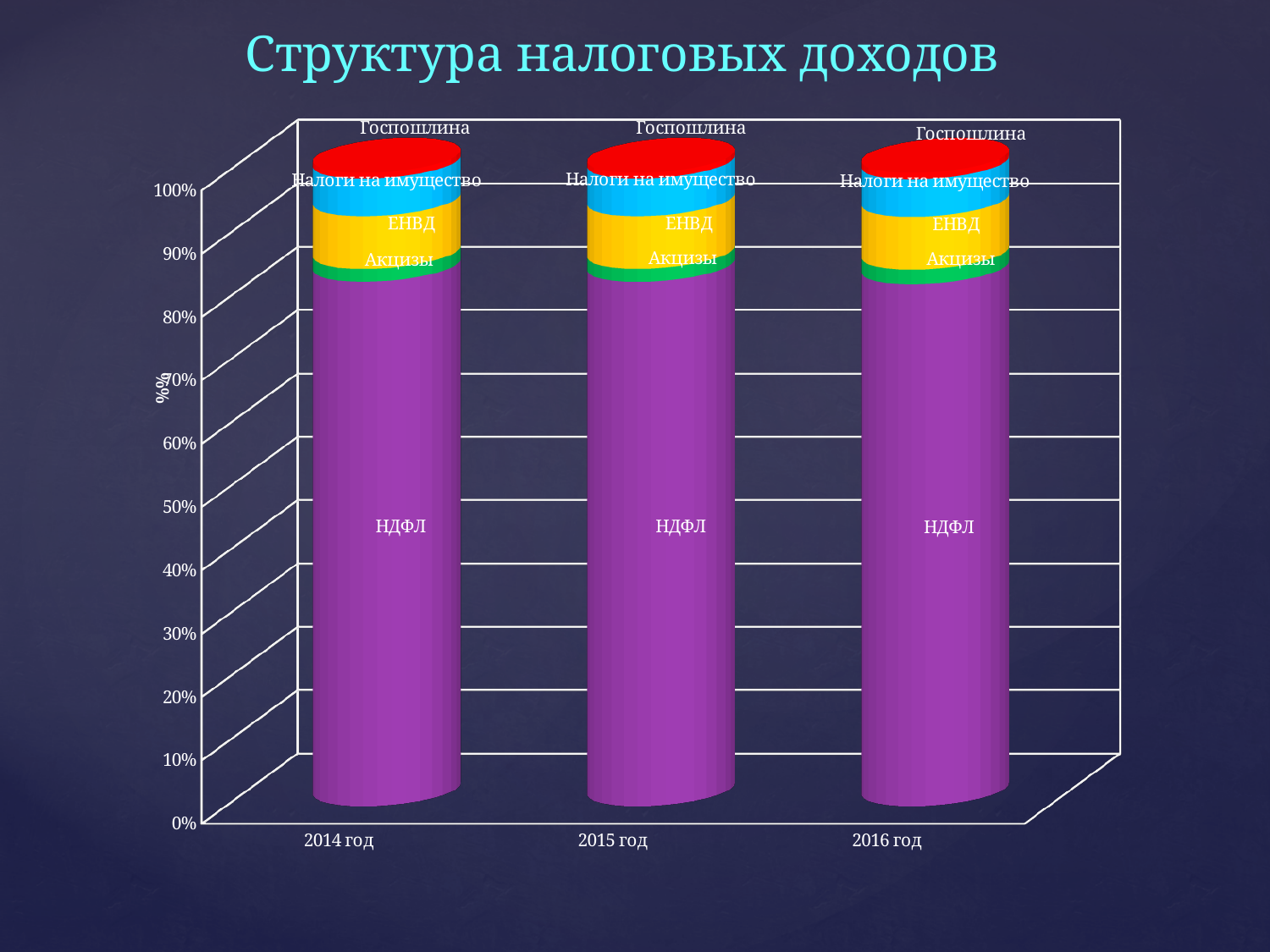
Which tax type makes up the largest share of tax revenue in 2016 год? НДФЛ Is the share of НДФЛ in 2016 год greater or less than 90%? less Which tax type makes up the largest share of tax revenue in 2014 год? НДФЛ Which tax type is shown at the top of each stacked bar? Госпошлина Is the share of НДФЛ in 2015 год greater or less than 70%? greater Is the share of НДФЛ in 2014 год greater or less than 80%? greater How many years (categories) are shown on the x axis? 3 Which segment is larger in 2015 год: НДФЛ or ЕНВД? НДФЛ What is the highest value shown on the y axis? 100% What kind of chart is shown on the slide? Stacked bar chart How many tax types (series) are labeled on each bar? 5 What is the title of the chart? Структура налоговых доходов